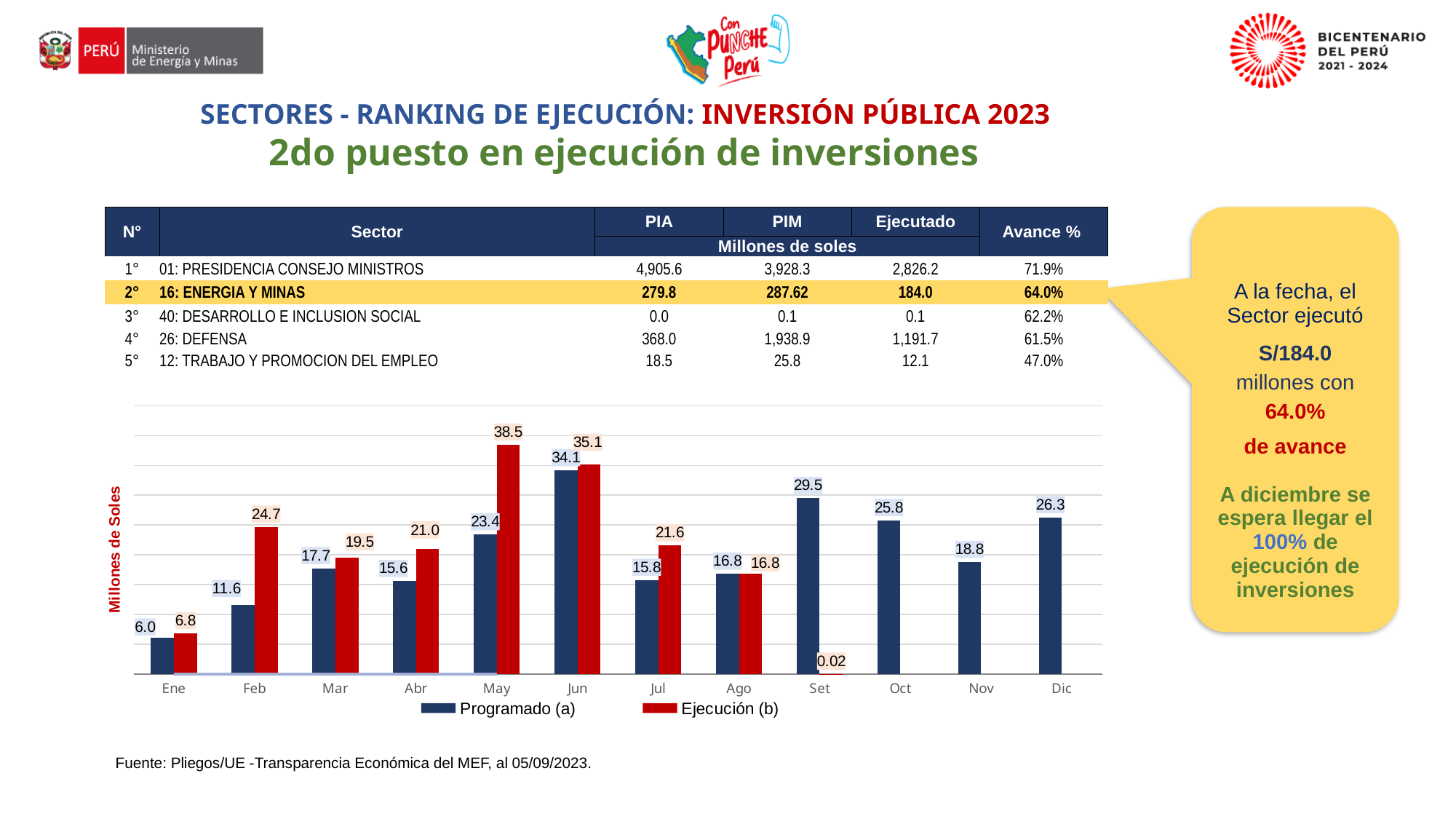
What is the Programado (a) value for May? 23.4 What is the Programado (a) value for Dic? 26.3 Which month has the lowest Programado (a) value? Ene Which month has the highest Ejecución (b) value? May What is the Ejecución (b) value for Set? 0.02 Which is larger in Jun, Programado (a) or Ejecución (b)? Ejecución (b) What kind of chart is shown on the slide? Bar chart What is the label of the y axis of the chart? Millones de Soles What is the Ejecución (b) value for Feb? 24.7 How many series does the chart legend list? 2 How many months are shown on the x axis of the chart? 12 What is the difference between the Ejecución (b) and Programado (a) values for May? 15.1